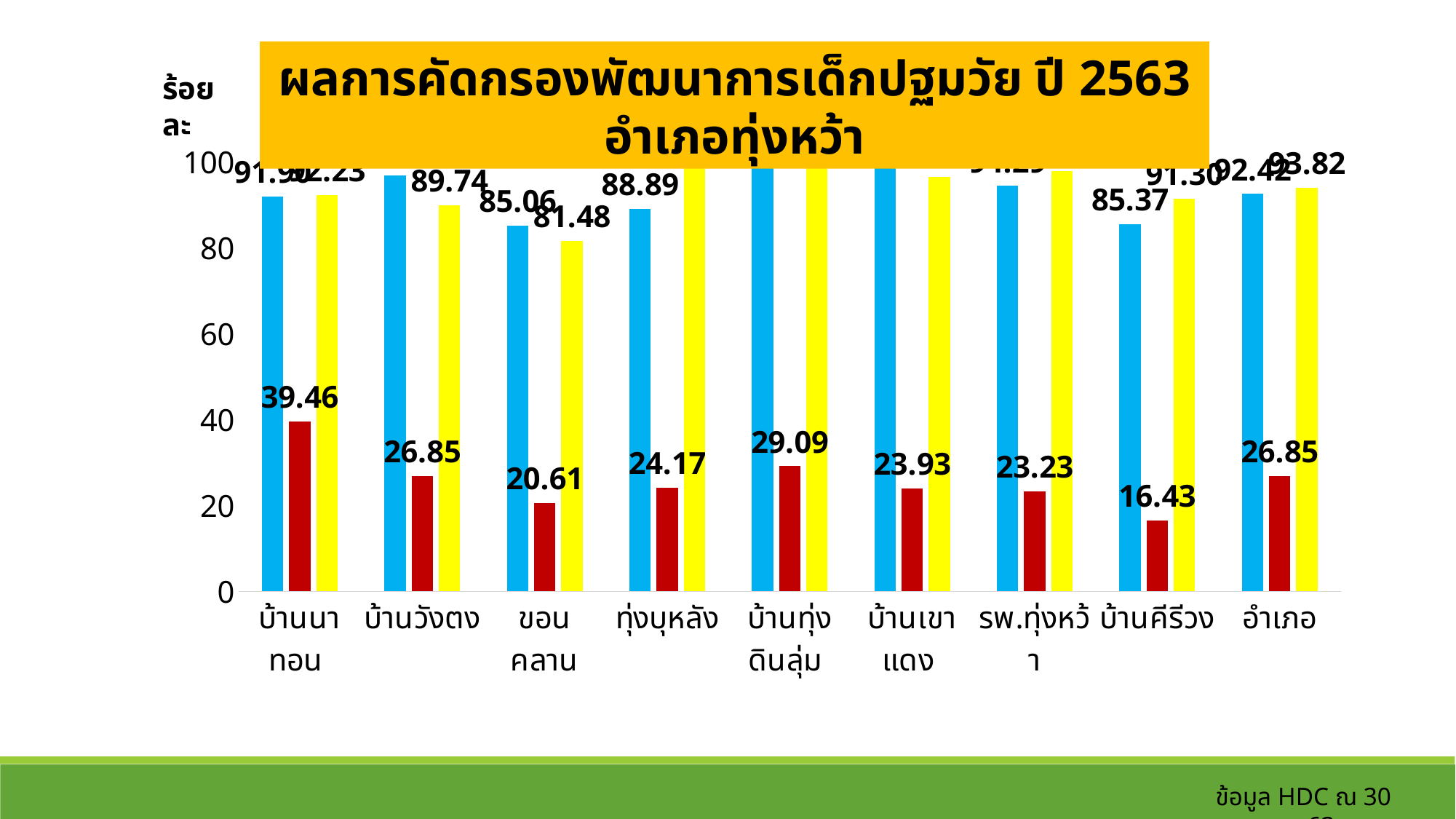
What year (ปี) is stated in the chart title? 2563 Which category has the lowest red bar? บ้านคีรีวง Is the value of the blue bar for บ้านวังตง greater or less than 80? greater How many categories are shown along the x axis of the chart? 9 What kind of chart is shown on the slide? bar chart What is the difference between the red bar values for บ้านนาทอน and บ้านคีรีวง? 23.03 What is the value of the red bar for บ้านคีรีวง? 16.43 What is the value of the red bar for บ้านนาทอน? 39.46 Which category has the highest red bar? บ้านนาทอน What is the value of the yellow bar for ขอนคลาน? 81.48 Which has the larger red bar, บ้านทุ่งดินลุ่ม or บ้านเขาแดง? บ้านทุ่งดินลุ่ม What is the value of the red bar for บ้านทุ่งดินลุ่ม? 29.09